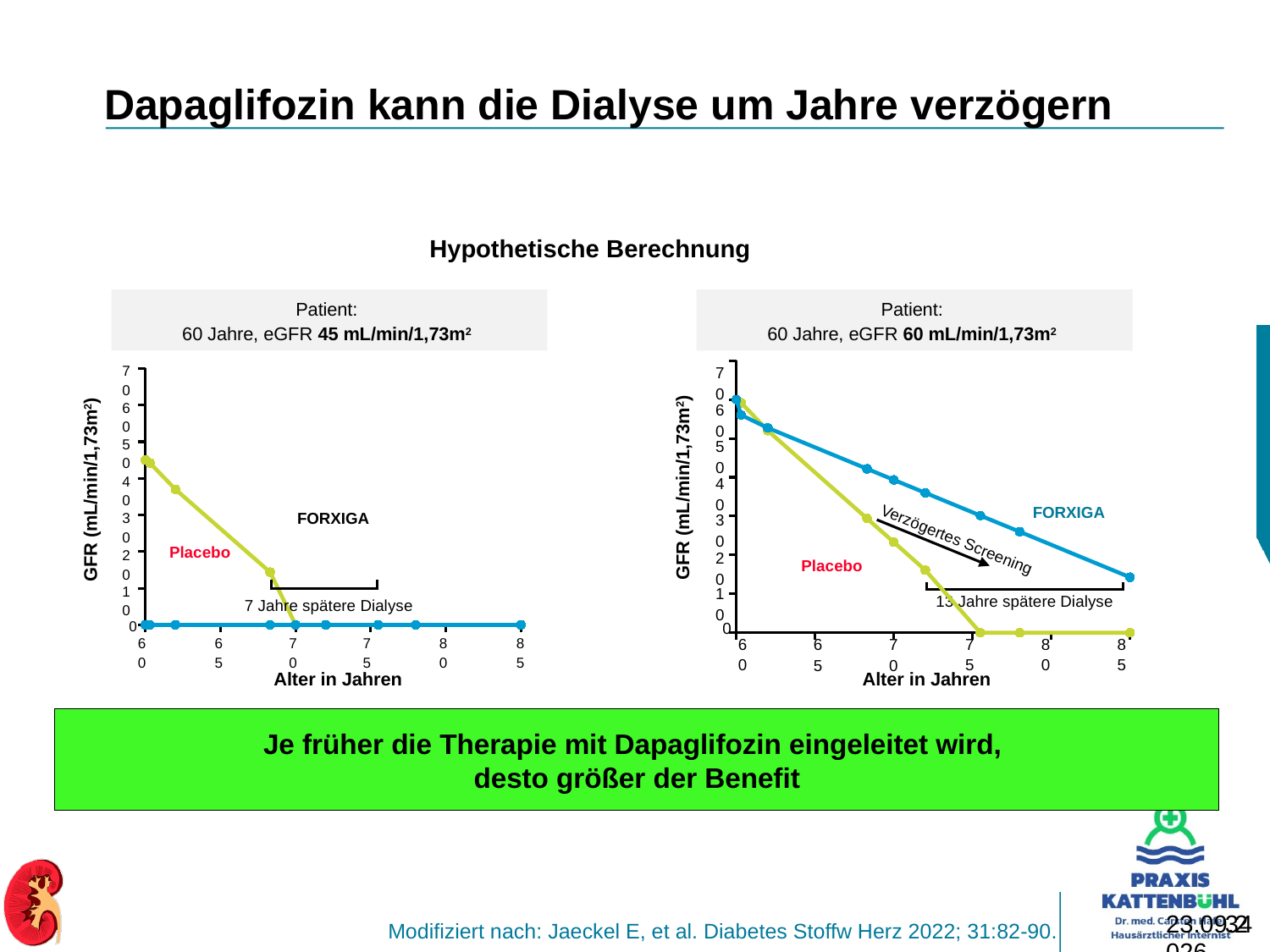
What kind of chart is the left chart (Patient: 60 Jahre, eGFR 45 mL/min/1,73m²)? line chart What kind of chart is the right chart (Patient: 60 Jahre, eGFR 60 mL/min/1,73m²)? line chart In the right chart (eGFR 60), at age 75, which series has the higher GFR value, FORXIGA or Placebo? FORXIGA In the right chart (eGFR 60), is the FORXIGA value at age 85 greater or less than 20? less In the left chart (eGFR 45), how many years later does the annotation say dialysis occurs? 7 Jahre In the right chart (eGFR 60), does the Placebo line rise or fall as age increases? fall In the right chart (eGFR 60), is the FORXIGA value at age 70 greater or less than 30? greater In the left chart (eGFR 45), what is the GFR value of the Placebo line at age 60? 45 In the right chart (eGFR 60), what is the GFR value of the Placebo line at age 60? 60 What is the x-axis title of the left chart (eGFR 45)? Alter in Jahren In the right chart (eGFR 60), how many series are plotted? 2